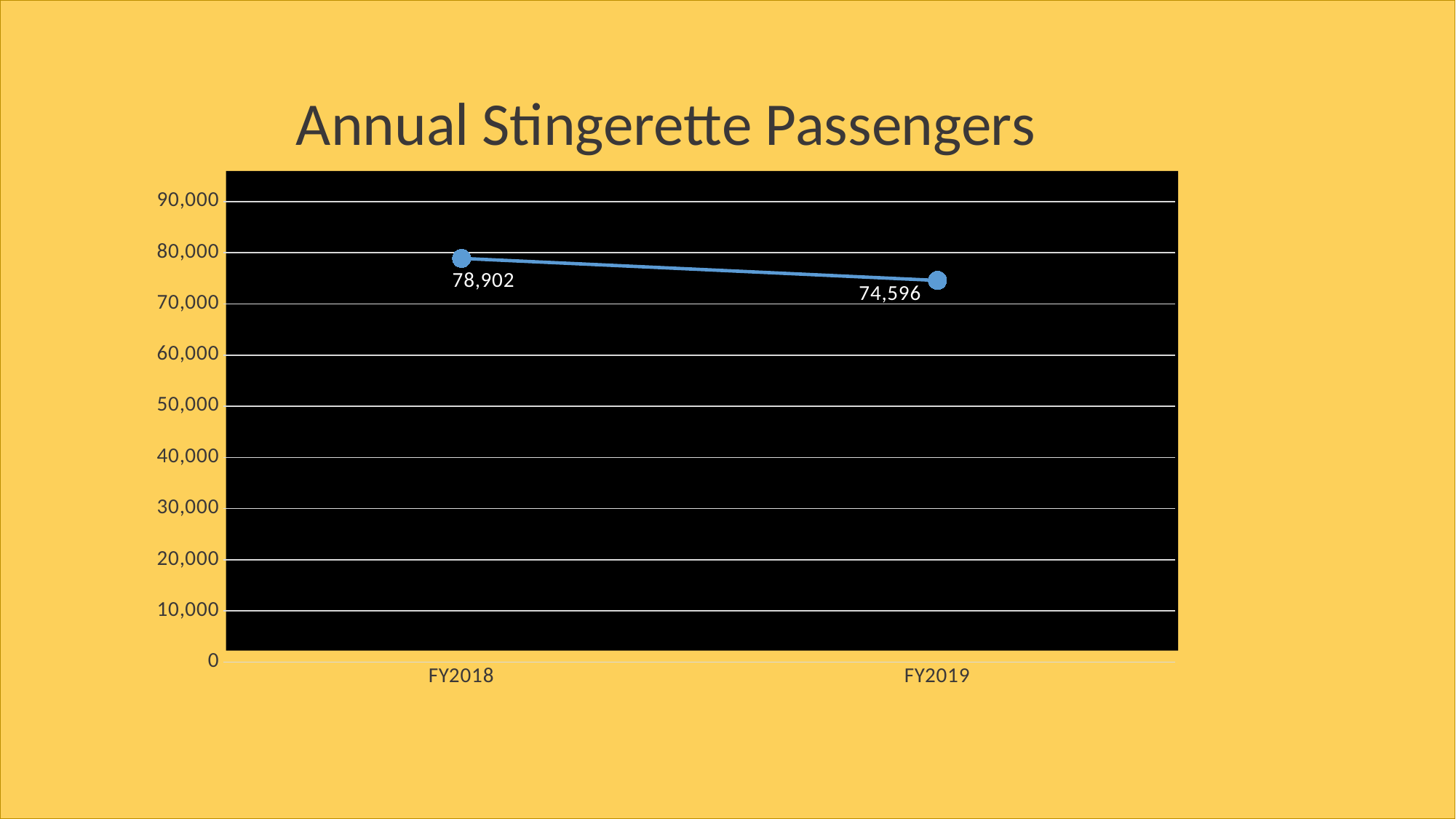
What is the value for FY2018? 78,902 Do the values rise or fall from FY2018 to FY2019? fall Which is larger, the value for FY2018 or FY2019? FY2018 What is the difference between the FY2018 and FY2019 values? 4,306 How many data points are plotted on the chart? 2 Which year has the lowest number of passengers? FY2019 Which year has the highest number of passengers? FY2018 What is the title of the chart? Annual Stingerette Passengers Is the value for FY2019 greater or less than 80,000? less Is the value for FY2018 greater or less than 70,000? greater What is the value for FY2019? 74,596 What kind of chart is shown? line chart